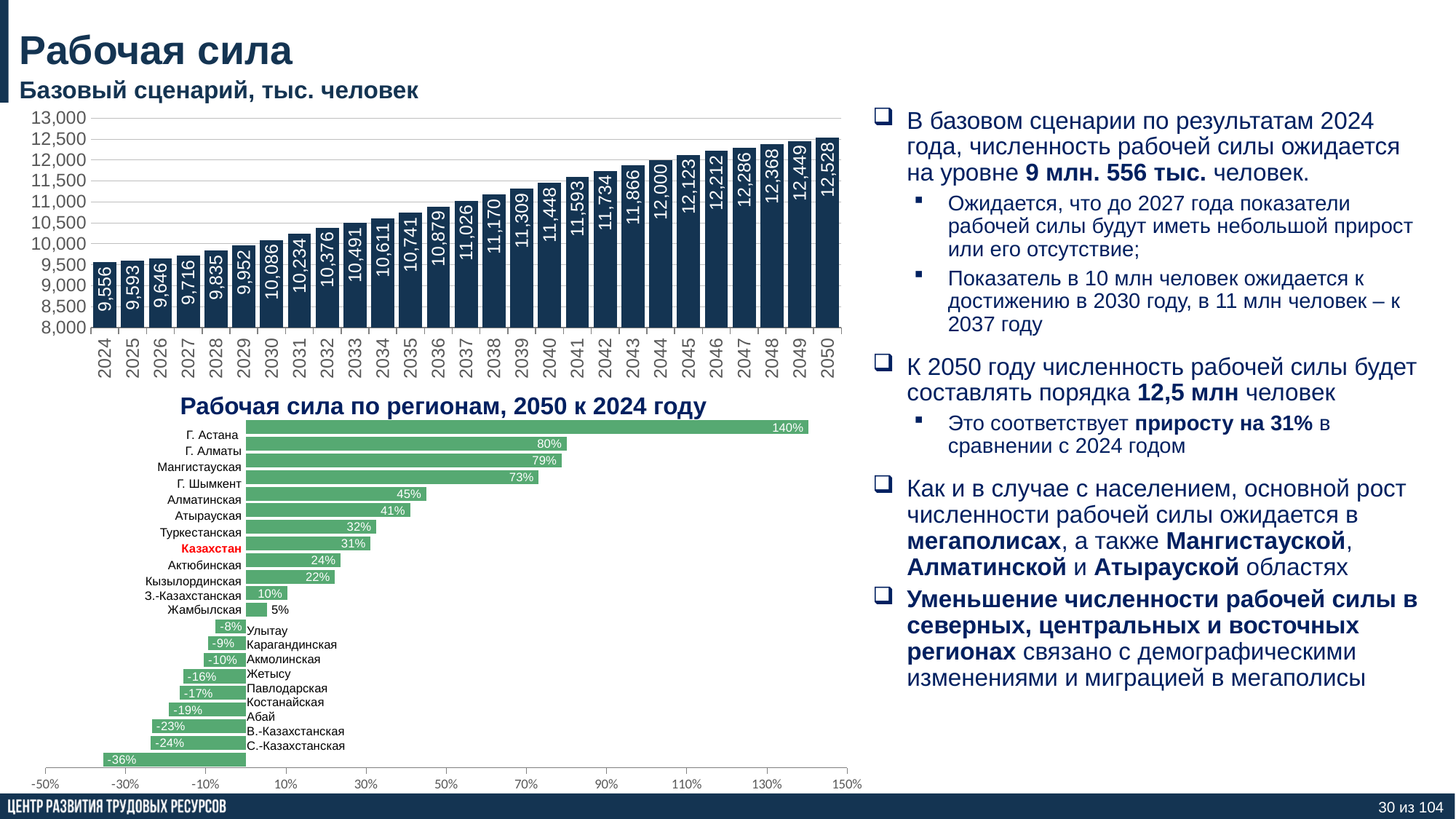
In the top chart (Базовый сценарий, тыс. человек), do the values rise or fall from 2024 to 2050? rise In the chart 'Рабочая сила по регионам, 2050 к 2024 году', what is the value for Г. Астана? 140% In the top chart (Базовый сценарий, тыс. человек), how many years are plotted? 27 In the chart 'Рабочая сила по регионам, 2050 к 2024 году', how many bars are plotted? 21 In the top chart (Базовый сценарий, тыс. человек), what is the value for 2037? 11,026 In the chart 'Рабочая сила по регионам, 2050 к 2024 году', what is the value for Казахстан? 31% In the top chart (Базовый сценарий, тыс. человек), what is the difference between the values for 2050 and 2024? 2,972 In the top chart (Базовый сценарий, тыс. человек), what is the value for 2024? 9,556 What kind of chart is the top chart (Базовый сценарий, тыс. человек)? bar chart In the chart 'Рабочая сила по регионам, 2050 к 2024 году', which region has the lowest value? С.-Казахстанская In the top chart (Базовый сценарий, тыс. человек), what is the value for 2050? 12,528 In the chart 'Рабочая сила по регионам, 2050 к 2024 году', which is larger: the value for Мангистауская or the value for Г. Шымкент? Мангистауская